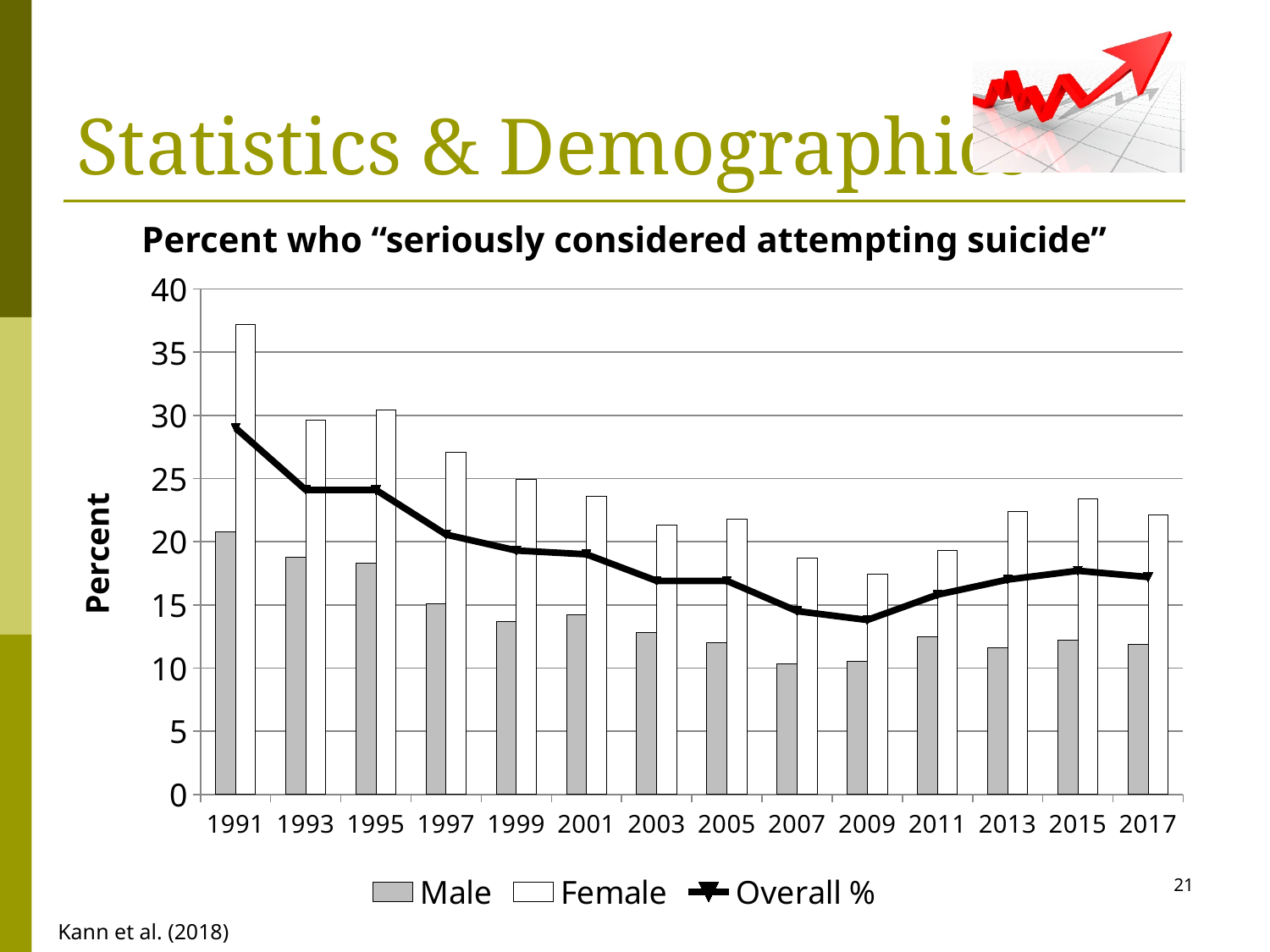
How many years are shown on the x axis? 14 Is the Overall % value for 2009 greater or less than 15? less How many series does the legend list? 3 What is the title of the chart? Percent who "seriously considered attempting suicide" In 1991, which is larger, the Male value or the Female value? Female What kind of chart is shown on the slide? A bar chart with a line Is the Overall % value for 1991 greater or less than 25? greater In which year is the Overall % value lowest? 2009 Is the Male value for 2007 greater or less than 15? less Does the Overall % line rise or fall from 1991 to 2009? Fall In which year is the Female value highest? 1991